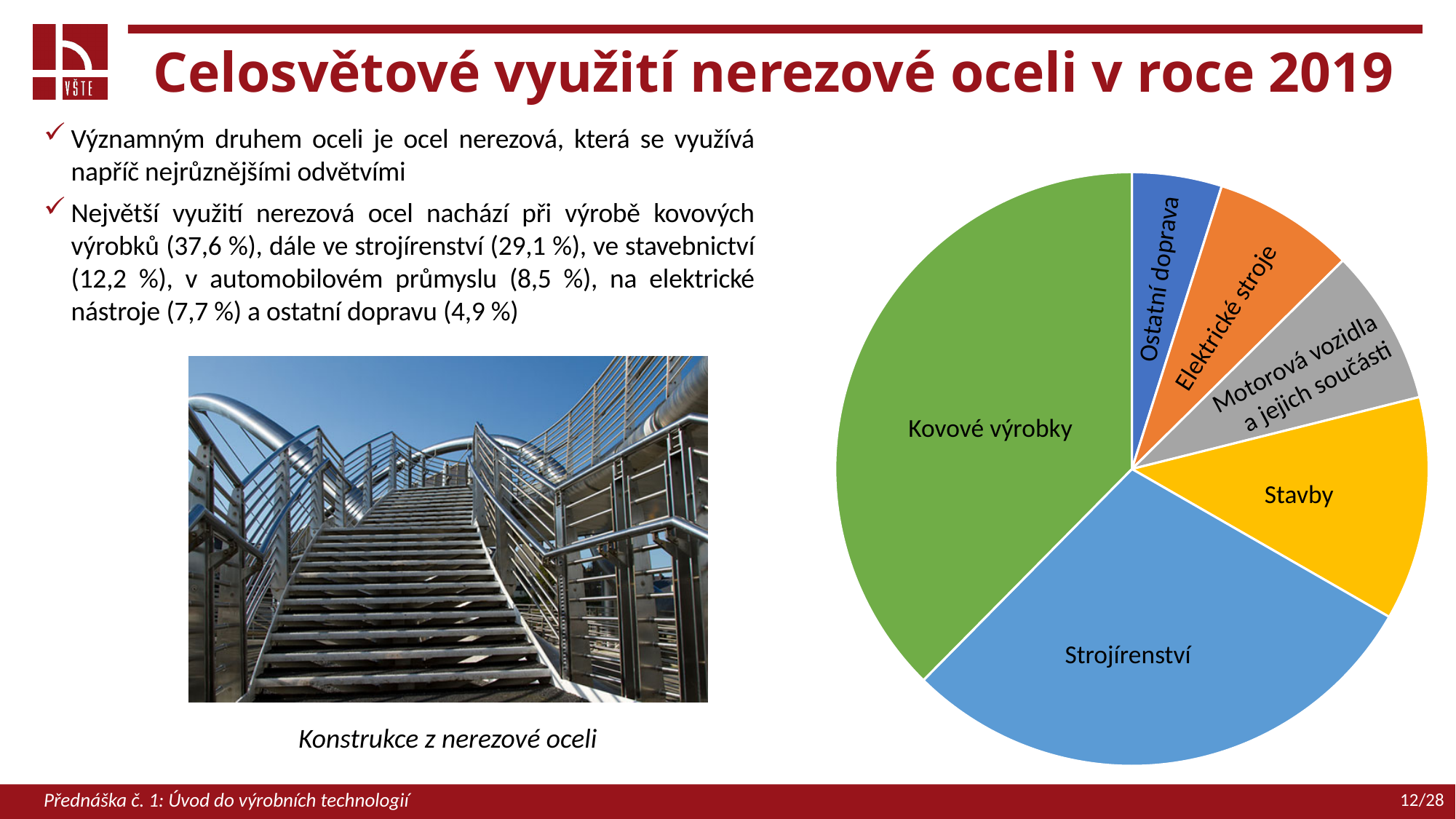
What colour is the Stavby slice? yellow According to the slide, what share of stainless steel use goes to Ostatní doprava? 4,9 % Which category has the largest slice in the pie chart? Kovové výrobky What colour is the Kovové výrobky slice? green According to the slide, what share of stainless steel use goes to Kovové výrobky? 37,6 % What kind of chart is shown on the slide? pie chart Which category has the smallest slice in the pie chart? Ostatní doprava According to the slide, what share of stainless steel use goes to Strojírenství? 29,1 % Which slice is larger, Strojírenství or Stavby? Strojírenství Which slice is larger, Kovové výrobky or Strojírenství? Kovové výrobky How many slices does the pie chart have? 6 Which slice is larger, Stavby or Elektrické stroje? Stavby